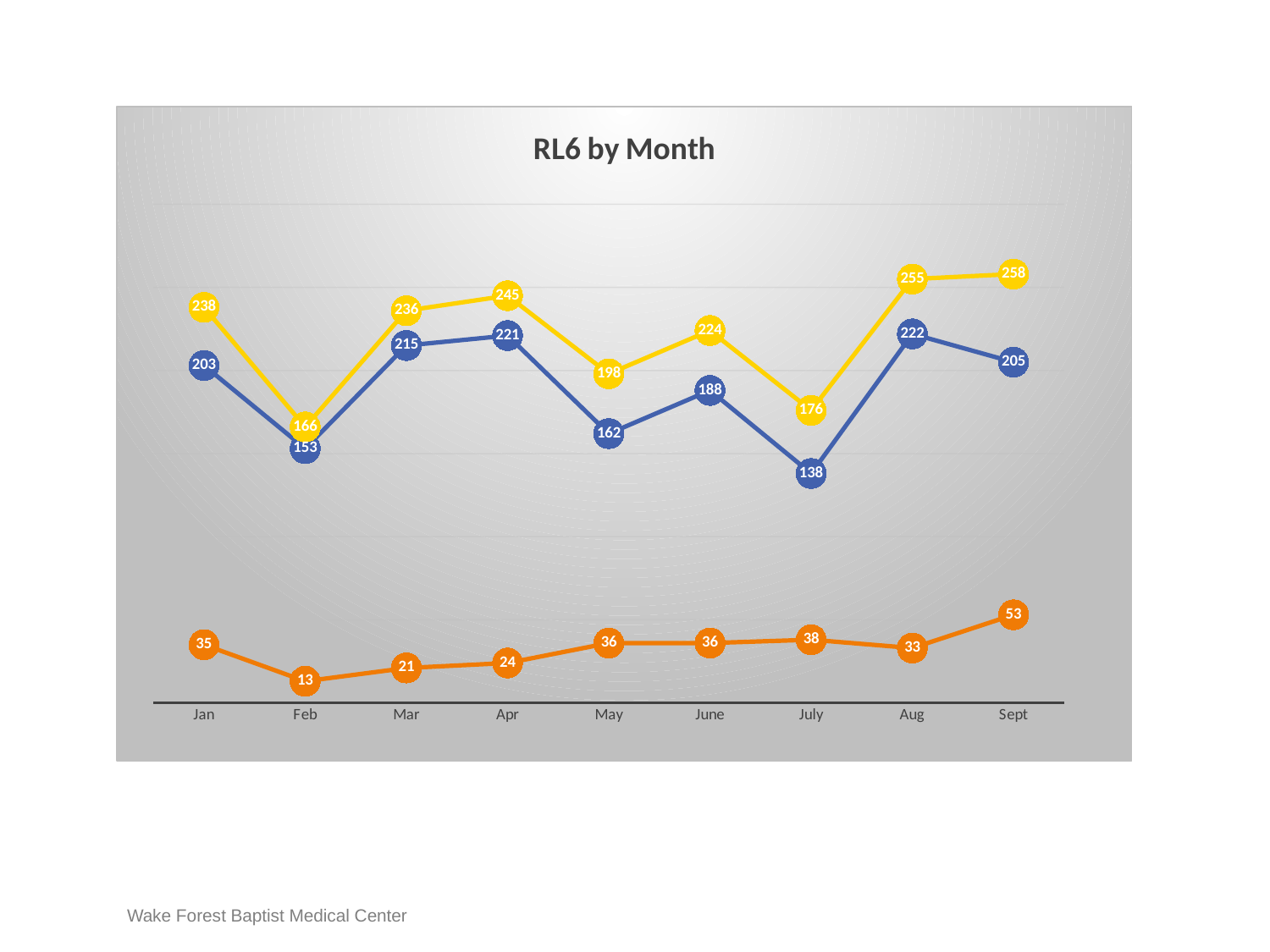
How many lines are plotted on the chart? 3 In which month is the orange line at its highest? Sept What is the title of the chart? RL6 by Month What is the value of the yellow line in Sept? 258 What is the difference between the yellow and blue values in Aug? 33 What is the value of the blue line in July? 138 What kind of chart is shown on the slide? line chart Which is larger, the blue value in Apr or the blue value in Aug? Aug In which month is the yellow line at its lowest? Feb Does the orange line rise or fall from Aug to Sept? rise What is the value of the orange line in Feb? 13 How many months are shown on the x axis? 9